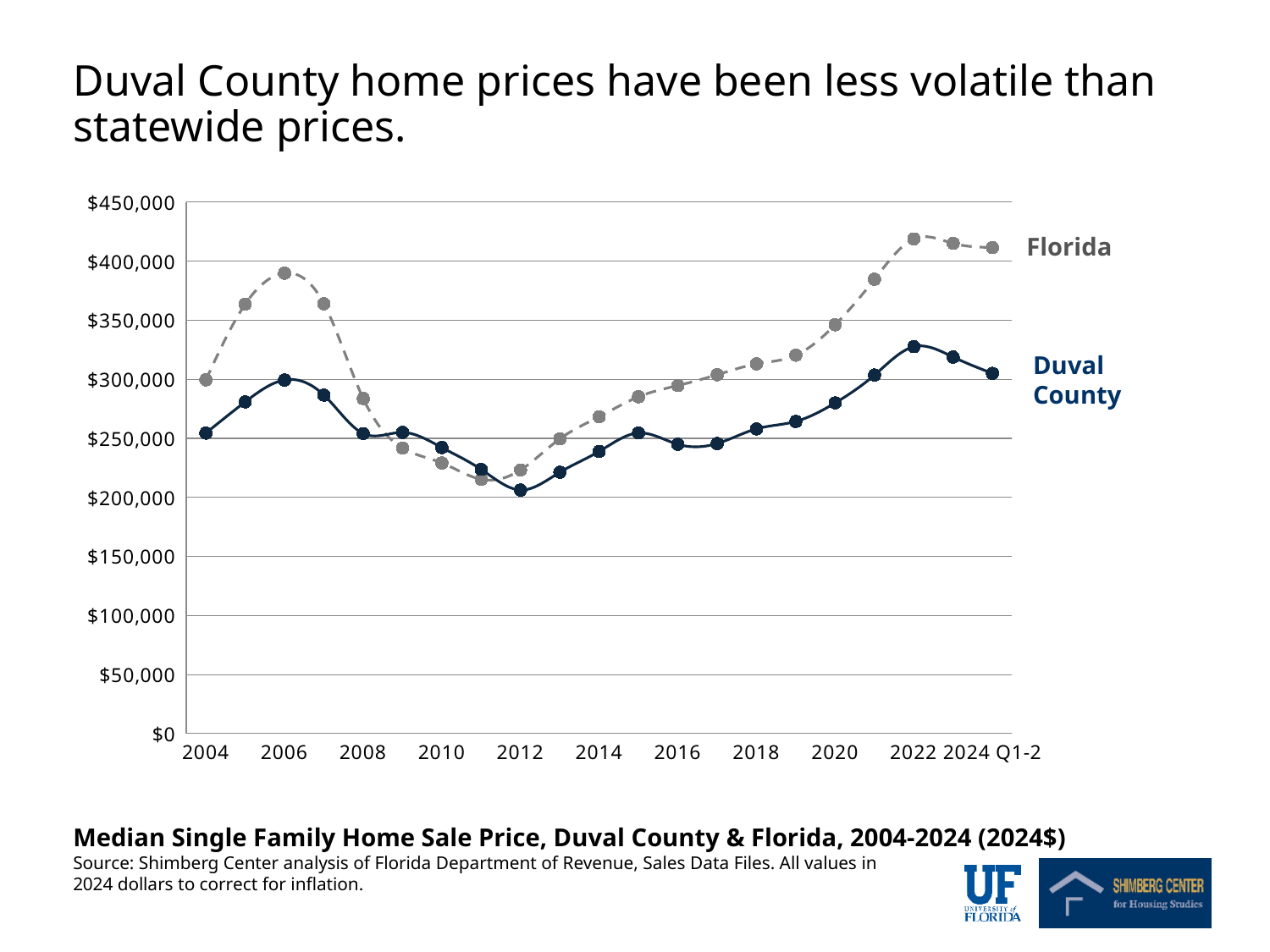
In which year does the Duval County series reach its highest value? 2022 In 2022, which series has the higher value, Florida or Duval County? Florida In 2009, which series has the higher value, Florida or Duval County? Duval County Is the Duval County value for 2020 greater or less than $250,000? greater In which year does the Duval County series reach its lowest value? 2012 What is the title of the chart? Median Single Family Home Sale Price, Duval County & Florida, 2004-2024 (2024$) Is the Florida value for 2006 greater or less than $350,000? greater What kind of chart is shown on the slide? line chart Is the Duval County value for 2012 greater or less than $250,000? less How many series are plotted on the chart? 2 Which series is drawn with a gray dashed line? Florida